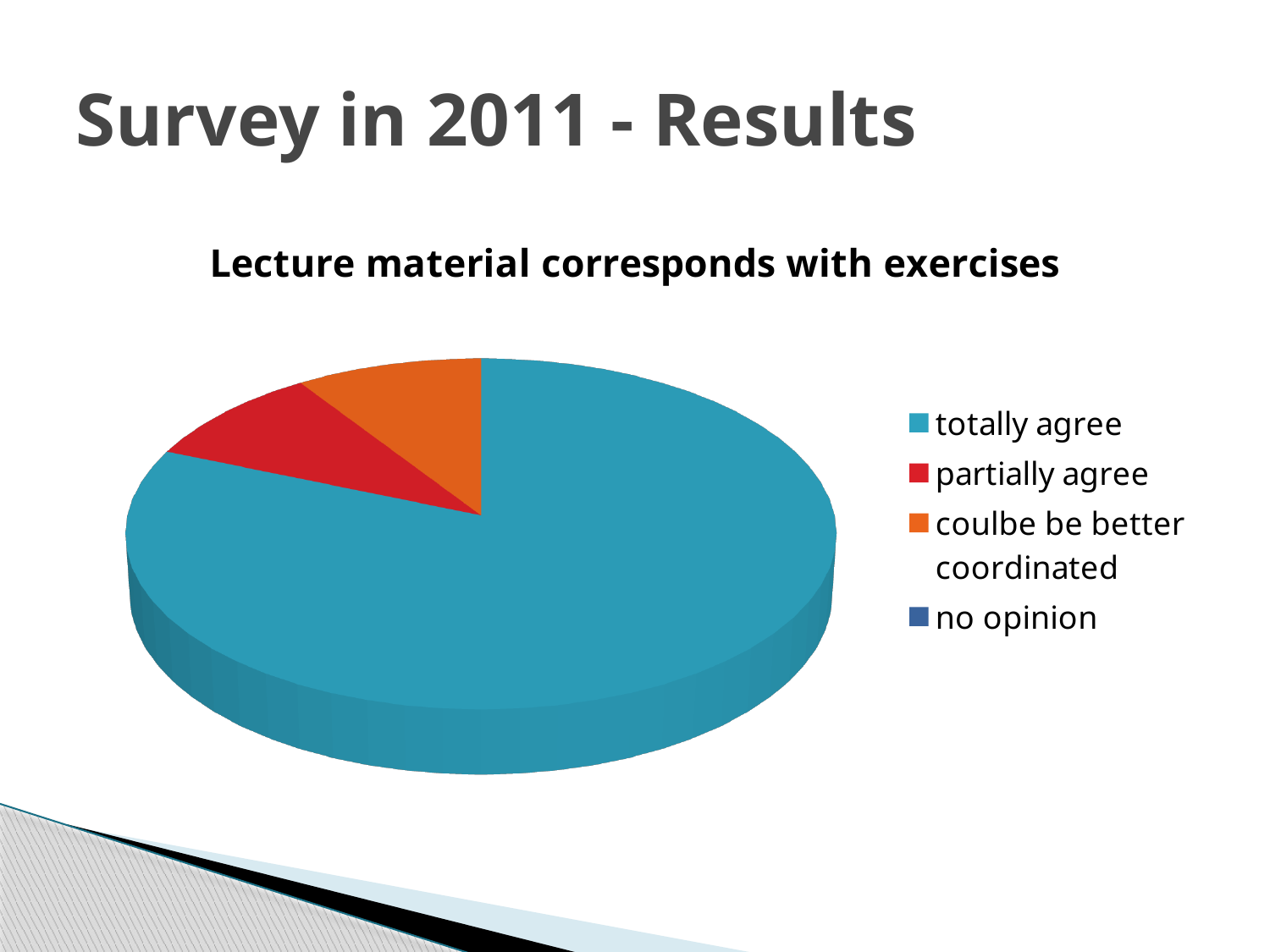
Which slice is larger: totally agree or coulbe be better coordinated? totally agree What is the title of the chart? Lecture material corresponds with exercises How many entries does the chart's legend list? 4 Does the 'totally agree' slice take up more or less than half of the pie? more Which slice is larger: totally agree or partially agree? totally agree Which colour represents the 'partially agree' category in the legend? red Which response category has the largest slice of the pie? totally agree What kind of chart is shown on the slide? pie chart